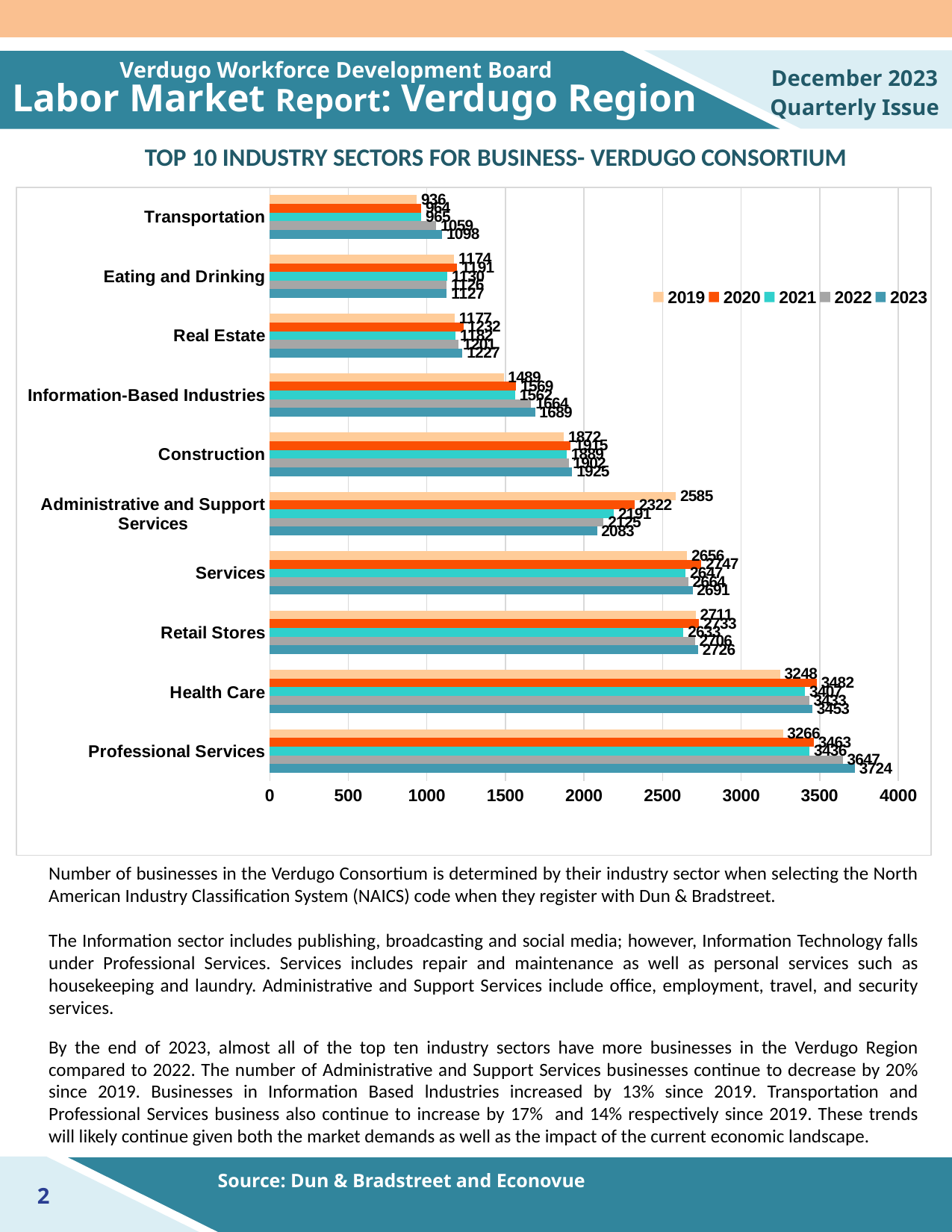
Is the value for Health Care in 2023 greater or less than 3000? greater What is the title of the chart? TOP 10 INDUSTRY SECTORS FOR BUSINESS- VERDUGO CONSORTIUM Which industry sector has the highest value in 2023? Professional Services What kind of chart is shown on the slide? bar chart What is the value for Transportation in 2019? 936 For Administrative and Support Services, which is larger: the 2019 value or the 2023 value? 2019 How many series does the legend list? 5 Which industry sector has the lowest value in 2019? Transportation How many industry sectors are shown on the chart? 10 What is the value for Administrative and Support Services in 2019? 2585 What is the difference between the 2023 and 2019 values for Professional Services? 458 What is the value for Professional Services in 2023? 3724